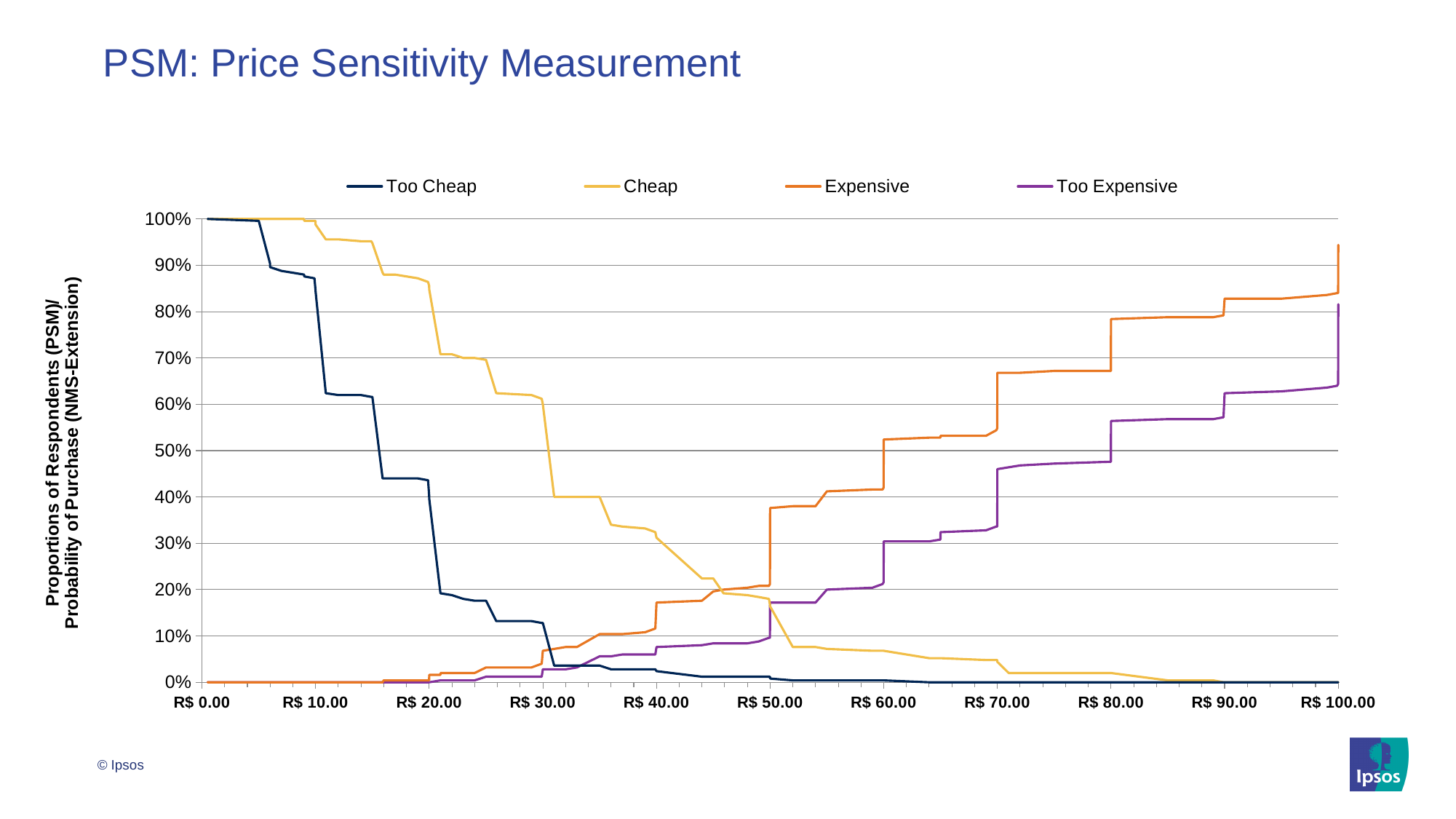
Is the value of the Cheap series at R$ 25.00 greater or less than 50%? greater What is the value of the Too Cheap series at R$ 0.00? 100% What kind of chart is shown on the slide? Line chart At R$ 62.00, which series has the higher value, Expensive or Too Expensive? Expensive At R$ 22.00, which series has the higher value, Cheap or Too Cheap? Cheap Does the Expensive series rise or fall as the price increases along the x axis? Rise How many series does the legend list? 4 Does the Too Cheap series rise or fall as the price increases along the x axis? Fall Is the value of the Too Expensive series at R$ 85.00 greater or less than 50%? greater Which series are listed in the legend? Too Cheap, Cheap, Expensive, Too Expensive What is the value of the Too Cheap series at R$ 100.00? 0% Is the value of the Expensive series at R$ 45.00 greater or less than 30%? less